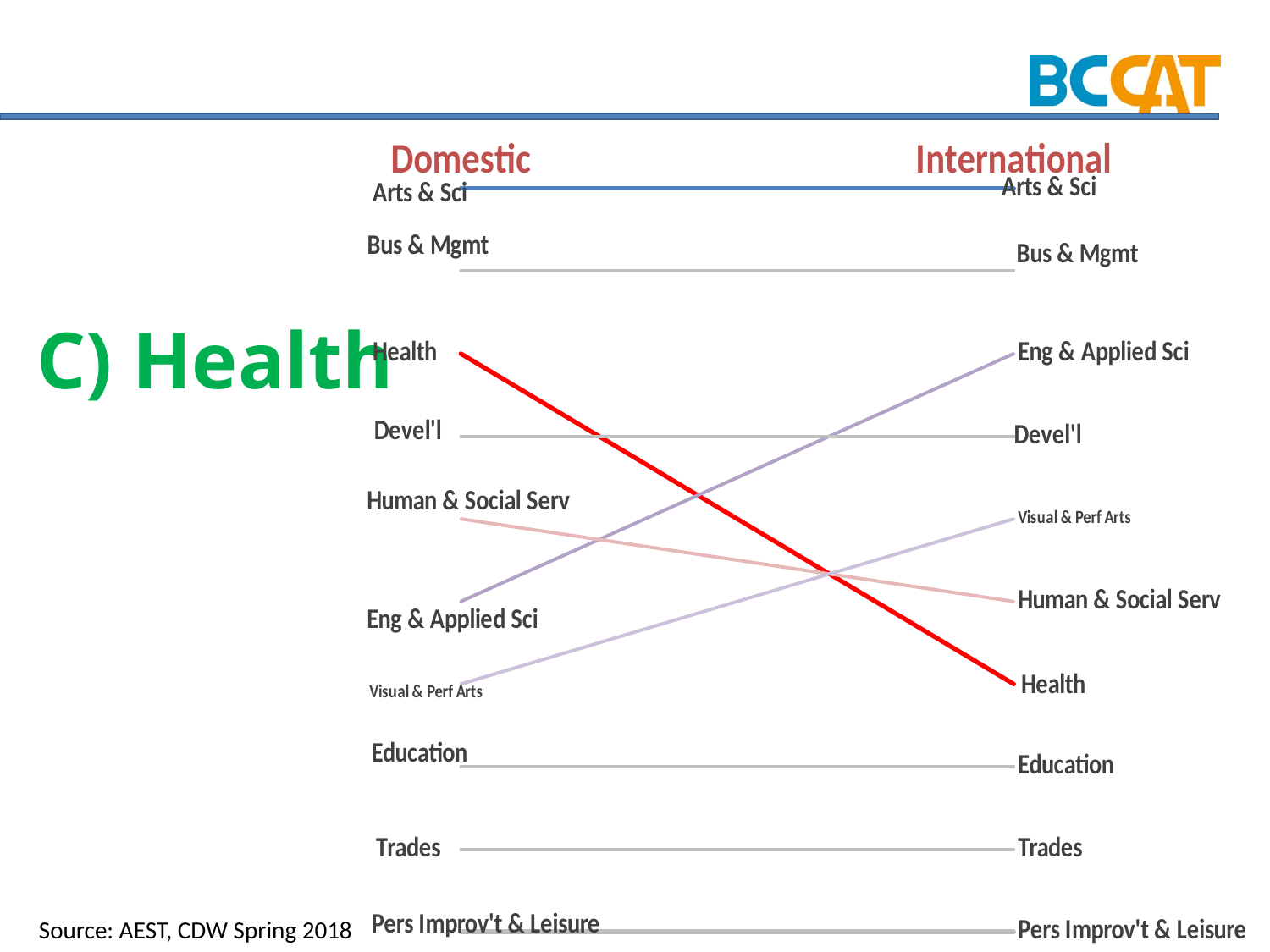
What kind of chart is shown on the slide? Slope chart (line chart) Which category is ranked 5th in the Domestic column? Human & Social Serv Which category's line is highlighted in red on the chart? Health What rank does Health hold in the International column? 7th What rank does Health hold in the Domestic column? 3rd Which category is ranked 3rd in the International column? Eng & Applied Sci Does Eng & Applied Sci rank higher in the Domestic column or the International column? International Which category is ranked first in both the Domestic and International columns? Arts & Sci How many program categories are listed in the Domestic column of the chart? 10 Does Health move up or down in rank from Domestic to International? Down Which category is ranked last in both the Domestic and International columns? Pers Improv't & Leisure What are the two column headings of the chart? Domestic and International